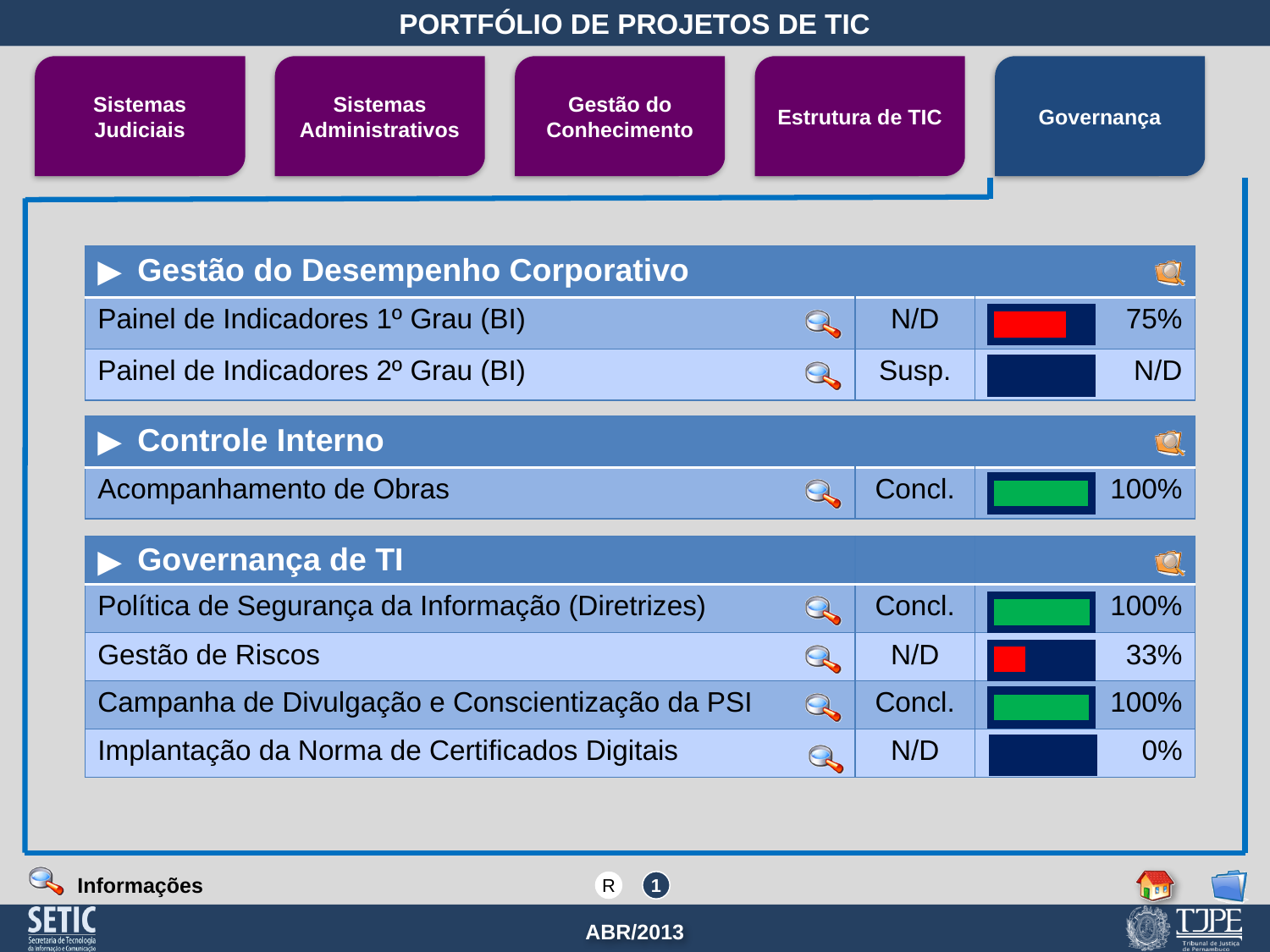
How many projects are listed under Governança de TI? 4 What progress percentage is shown for Gestão de Riscos? 33% What status is shown for Painel de Indicadores 2º Grau (BI)? Susp. How many projects on the slide show a progress of 100%? 3 What status is shown for Acompanhamento de Obras? Concl. Under Governança de TI, which project has the lowest non-zero progress percentage? Gestão de Riscos Which tab at the top of the slide is currently selected? Governança What progress percentage is shown for Implantação da Norma de Certificados Digitais? 0% What progress percentage is shown for Painel de Indicadores 1º Grau (BI)? 75% Which has a higher progress percentage, Painel de Indicadores 1º Grau (BI) or Gestão de Riscos? Painel de Indicadores 1º Grau (BI) Under Governança de TI, which project has the lowest progress percentage? Implantação da Norma de Certificados Digitais What is the difference in progress between Painel de Indicadores 1º Grau (BI) and Gestão de Riscos? 42 percentage points